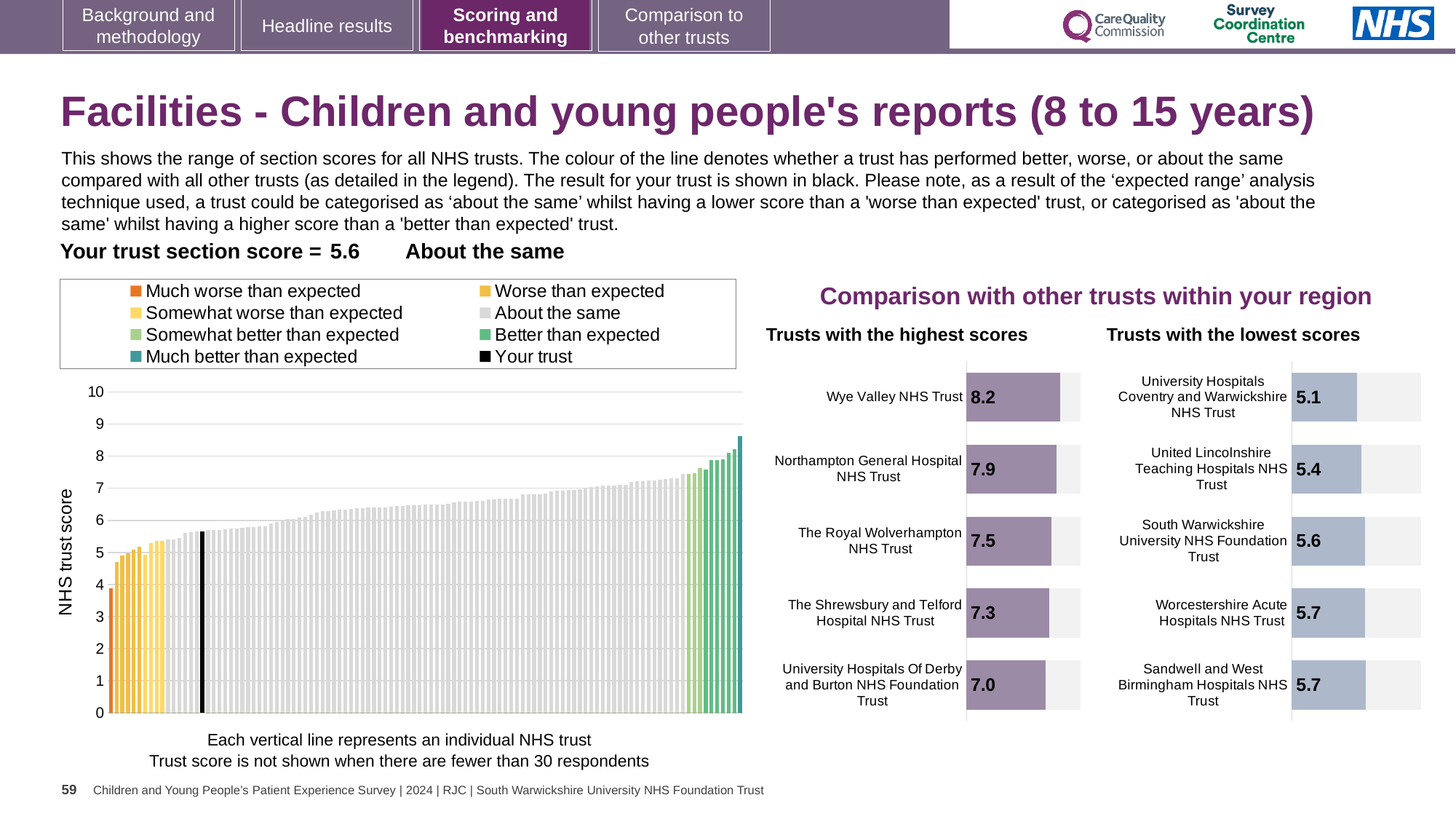
In the 'Trusts with the lowest scores' chart, which trust has the lowest score? University Hospitals Coventry and Warwickshire NHS Trust How many trusts are listed in the 'Trusts with the lowest scores' chart? 5 In the 'Trusts with the highest scores' chart, which has a higher score: Northampton General Hospital NHS Trust or The Shrewsbury and Telford Hospital NHS Trust? Northampton General Hospital NHS Trust In the 'Trusts with the highest scores' chart, what is the difference between the scores of Wye Valley NHS Trust and University Hospitals Of Derby and Burton NHS Foundation Trust? 1.2 In the 'Trusts with the highest scores' chart, what is the score for Wye Valley NHS Trust? 8.2 In the 'Trusts with the highest scores' chart, which trust has the lowest score shown? University Hospitals Of Derby and Burton NHS Foundation Trust In the 'Trusts with the highest scores' chart, what is the score for The Royal Wolverhampton NHS Trust? 7.5 In the 'NHS trust score' chart on the left, is the value of the tallest bar greater or less than 8? greater What kind of chart is the 'NHS trust score' chart on the left of the slide? Bar chart In the 'Trusts with the lowest scores' chart, what is the score for United Lincolnshire Teaching Hospitals NHS Trust? 5.4 In the 'Trusts with the lowest scores' chart, what is the difference between the scores of Sandwell and West Birmingham Hospitals NHS Trust and University Hospitals Coventry and Warwickshire NHS Trust? 0.6 In the 'NHS trust score' chart on the left, do the bar values rise or fall from left to right? Rise